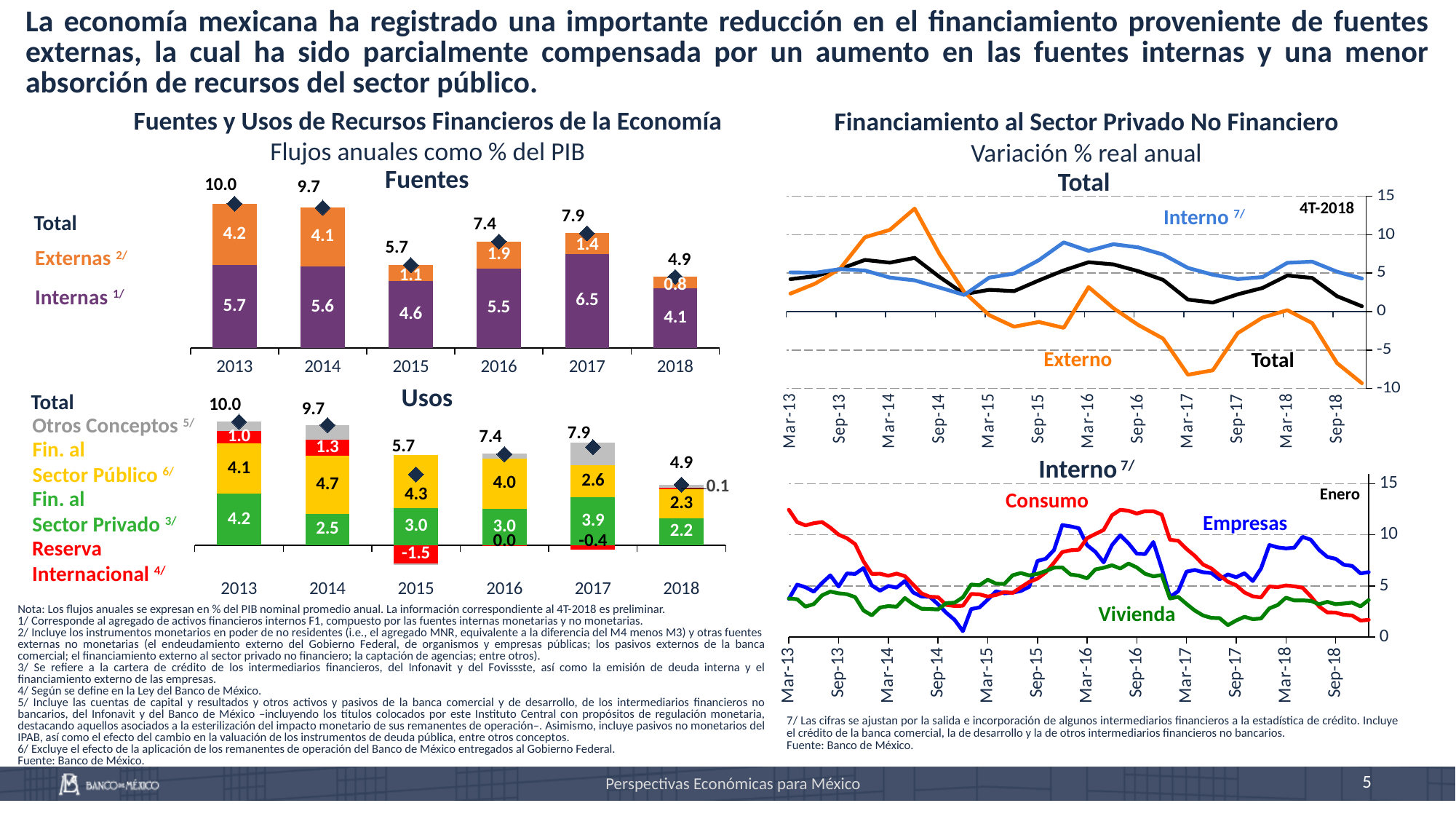
In the 'Usos' chart, what is the value of Fin. al Sector Público for 2014? 4.7 In the 'Fuentes' chart, which year has the lowest total? 2018 What kind of chart is the 'Usos' chart? Stacked bar chart In the 'Fuentes' chart, what is the total value for 2013? 10.0 In the 'Fuentes' chart, what is the value of Externas for 2016? 1.9 In the 'Usos' chart, what is the value of Reserva Internacional for 2015? -1.5 In the 'Usos' chart, which is larger in 2013: Fin. al Sector Privado or Fin. al Sector Público? Fin. al Sector Privado In the 'Interno' line chart on the right, is the value of Consumo at Sep-16 greater or less than 10? greater In the 'Fuentes' chart, what is the difference between the Internas values for 2017 and 2018? 2.4 How many years are shown on the x axis of the 'Fuentes' chart? 6 How many series are shown in the 'Interno' line chart on the right? 3 In the 'Total' line chart on the right, is the value of Externo at Sep-18 greater or less than -5? less